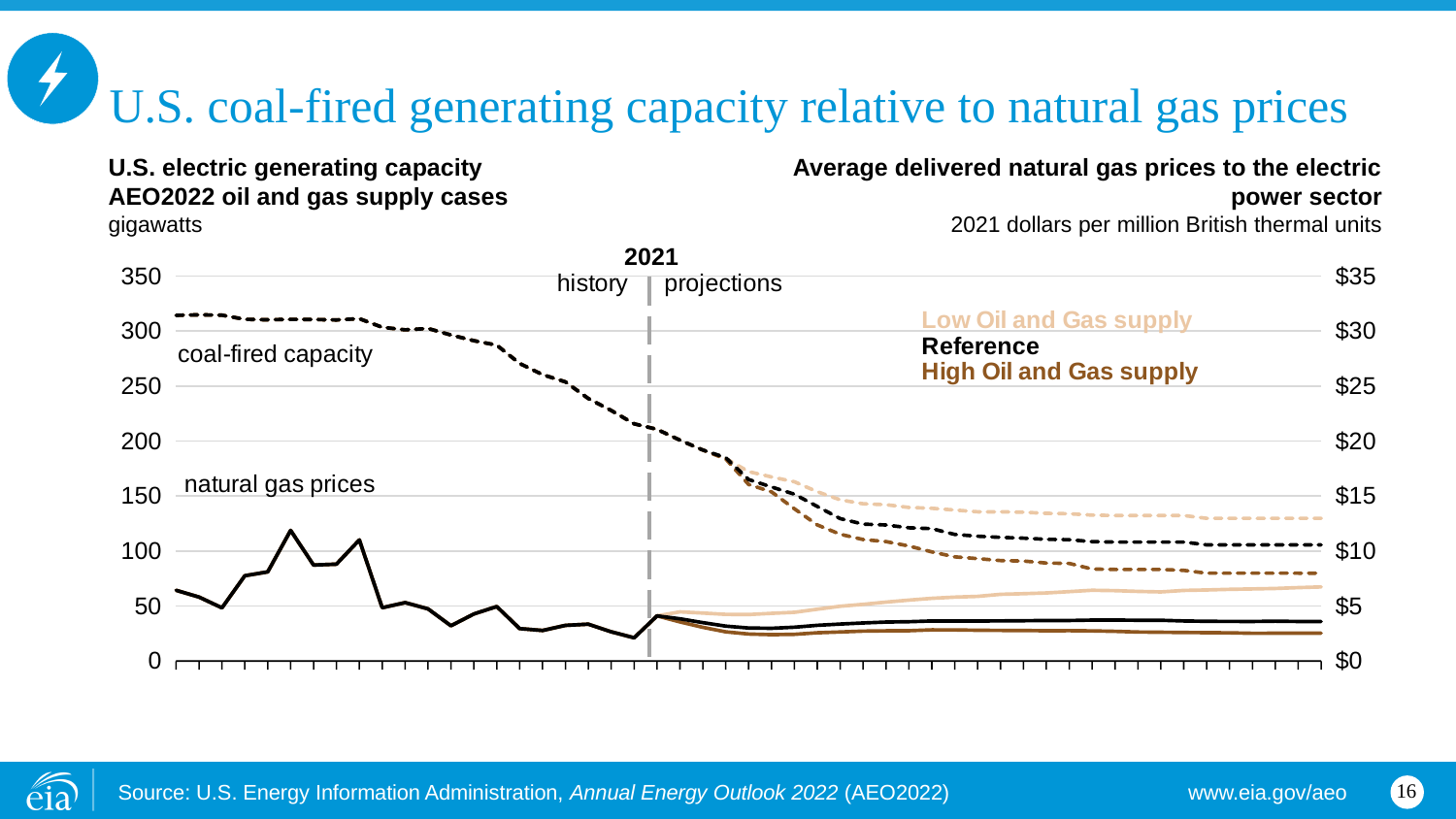
What kind of chart is shown on the slide? line chart What unit is used for the right axis (natural gas prices)? 2021 dollars per million British thermal units Is the peak historical natural gas price greater or less than $10? greater Is the coal-fired capacity in the High Oil and Gas supply case at the end of the projection period greater or less than 100 gigawatts? less Is the coal-fired capacity in 2021 greater or less than 250 gigawatts? less What unit is used for the left axis (electric generating capacity)? gigawatts Which year marks the boundary between history and projections? 2021 How many oil and gas supply cases are listed in the legend? 3 Which supply case has the highest projected coal-fired capacity at the end of the projection period? Low Oil and Gas supply Which supply case has the lowest projected natural gas price at the end of the projection period? High Oil and Gas supply Does coal-fired capacity rise or fall over the projection period? fall